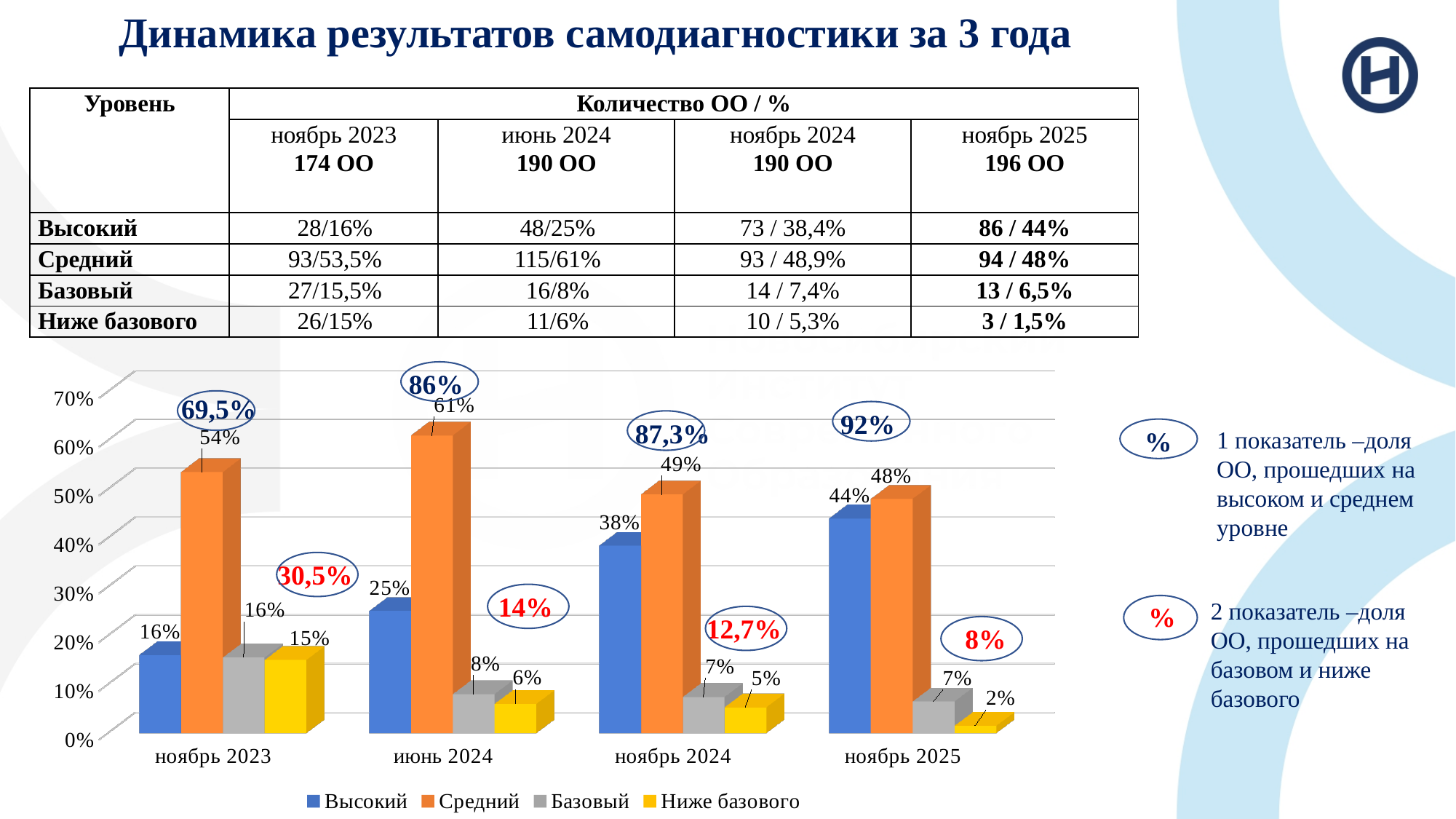
Which category has the highest value for Средний? июнь 2024 Is the value for Средний in июнь 2024 greater or less than 60%? greater What kind of chart is shown on the slide? bar chart What is the value for Высокий in ноябрь 2025? 44% Which is larger in ноябрь 2024: Высокий or Средний? Средний Which category has the lowest value for Ниже базового? ноябрь 2025 What is the difference between the Высокий values for ноябрь 2025 and ноябрь 2023? 28% How many categories are shown on the x axis of the chart? 4 What is the value for Ниже базового in июнь 2024? 6% How many series does the chart legend list? 4 What is the value for Средний in ноябрь 2023? 54% Do the values for Высокий rise or fall from ноябрь 2023 to ноябрь 2025? rise